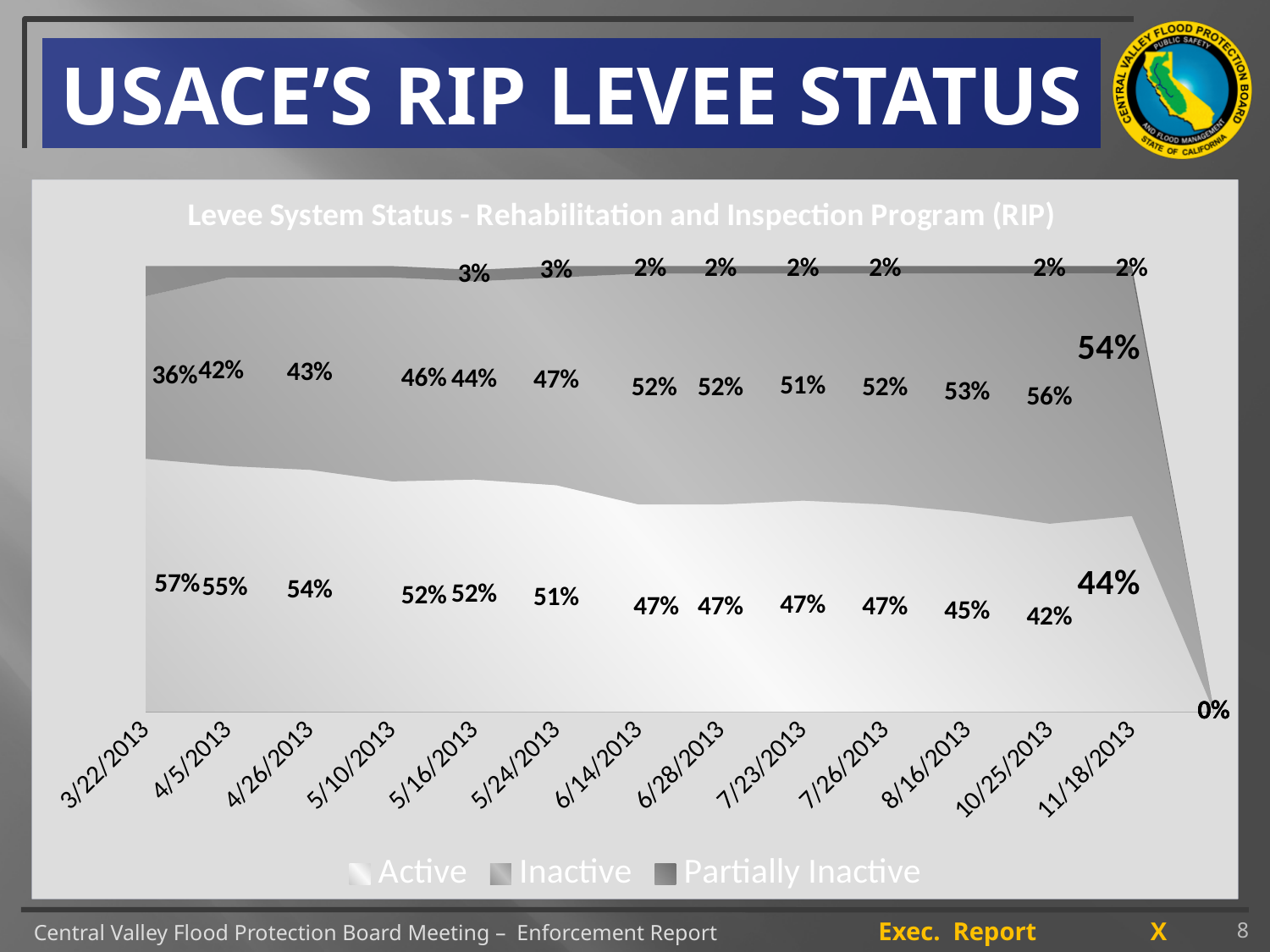
What kind of chart is shown on the slide? Area chart Does the Active series generally rise or fall from 3/22/2013 to 10/25/2013? Fall What is the Partially Inactive value on 6/14/2013? 2% What is the Inactive value on 5/16/2013? 44% On 3/22/2013, which is larger, the Active value or the Inactive value? Active What are the three legend entries of the chart? Active, Inactive, Partially Inactive How many series does the legend list? 3 On which date is the Inactive value highest? 10/25/2013 By how many percentage points does the Active value on 3/22/2013 exceed the Active value on 11/18/2013? 13 percentage points What is the Active value on 3/22/2013? 57% On which date is the Active value lowest? 10/25/2013 What is the Inactive value on 11/18/2013? 54%